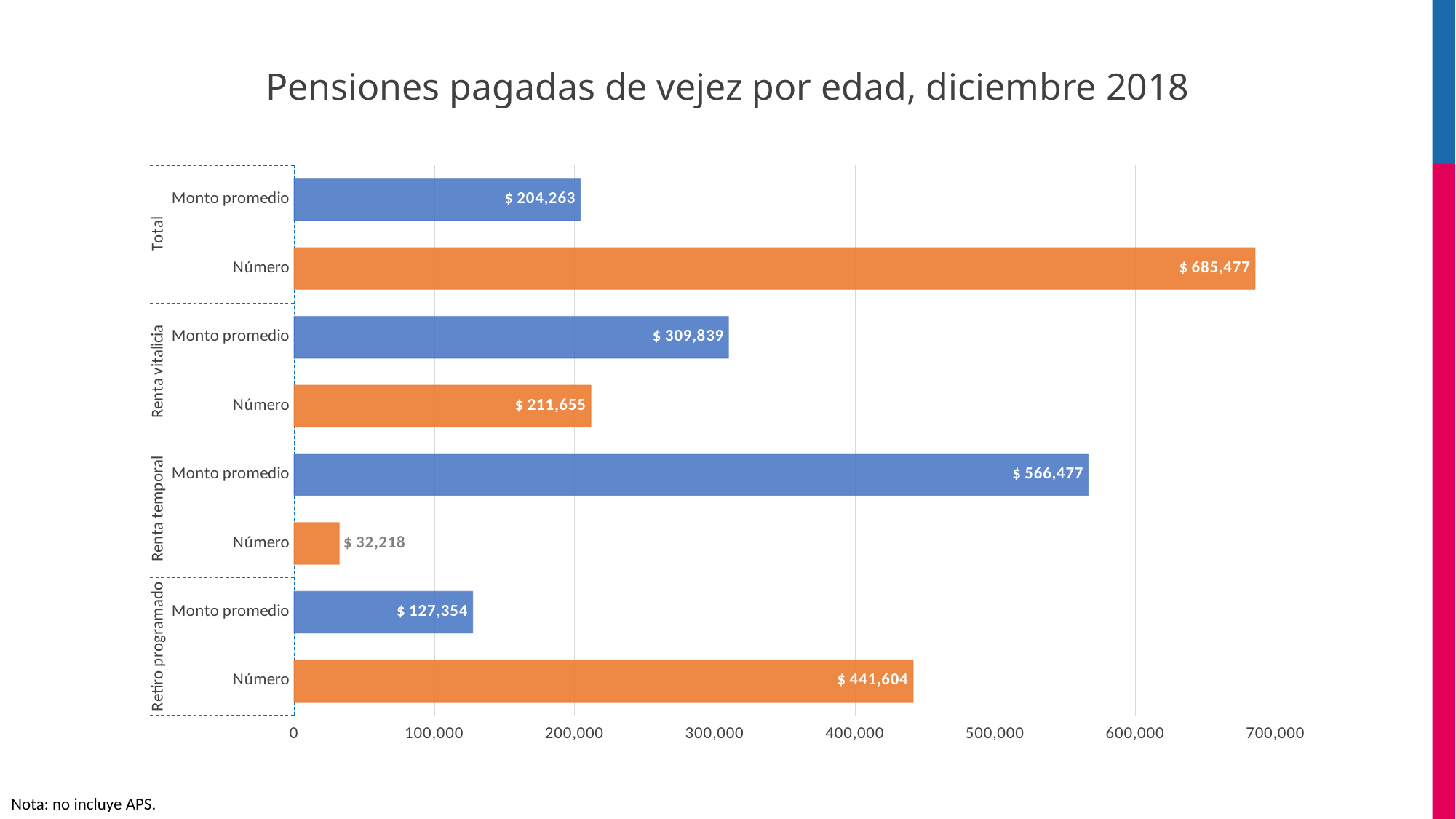
How many bars are plotted in the chart? 8 What is the title of the chart? Pensiones pagadas de vejez por edad, diciembre 2018 What kind of chart is shown on the slide? Bar chart What is the difference between the Número values for Retiro programado and Renta vitalicia? 229,949 What is the Monto promedio value for Retiro programado? $ 127,354 Which group has the highest Monto promedio value? Renta temporal Which group has the lowest Número value? Renta temporal Which is larger: the Monto promedio for Total or the Número for Renta vitalicia? Número for Renta vitalicia What is the Número value for Renta temporal? $ 32,218 What is the Número value for Total? $ 685,477 What is the Monto promedio value for Renta vitalicia? $ 309,839 Is the Monto promedio value for Renta temporal greater or less than 500,000? greater